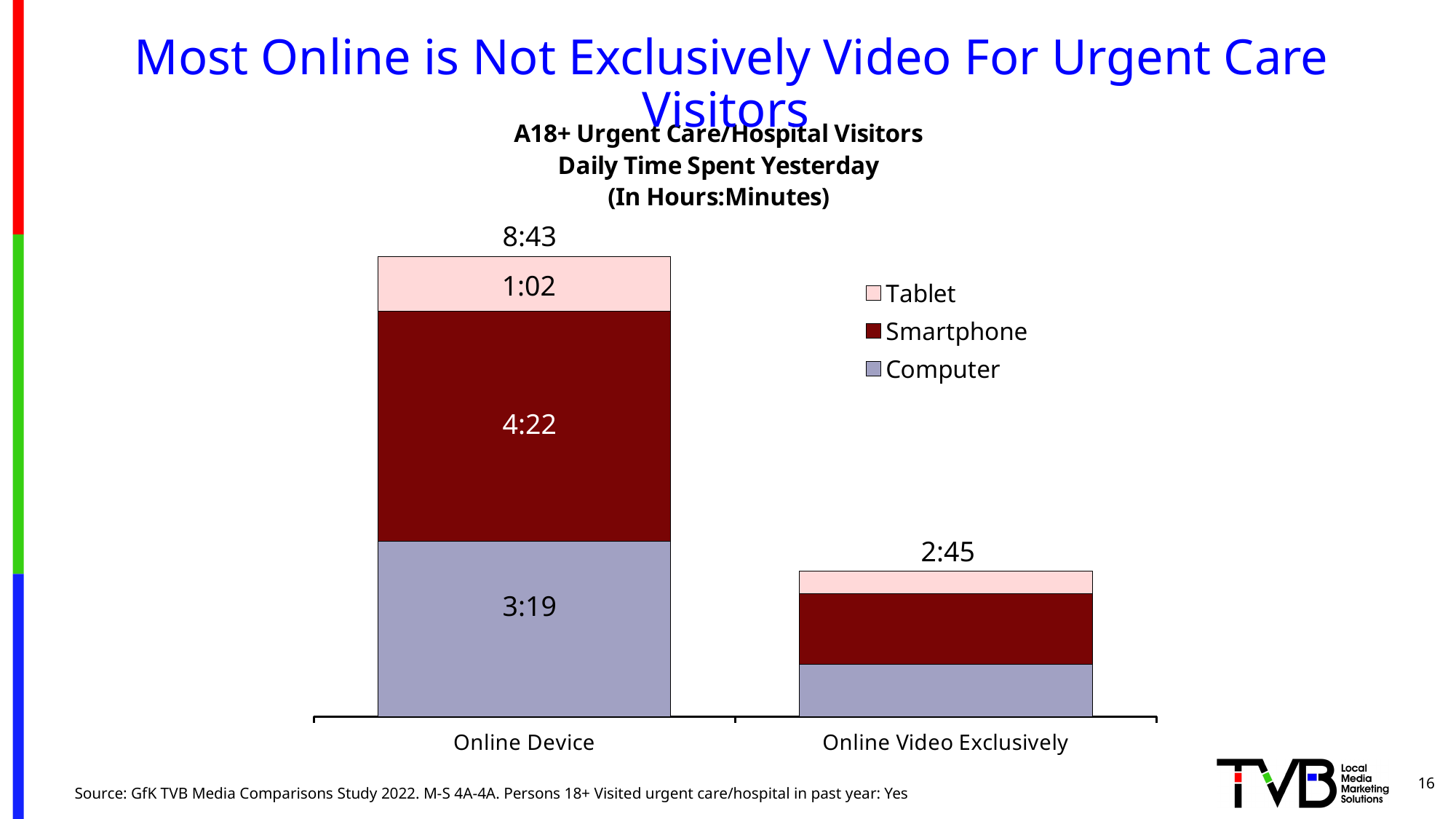
What is the difference between the total for Online Device and the total for Online Video Exclusively? 5:58 How many series does the chart's legend list? 3 Which category has the larger total daily time spent, Online Device or Online Video Exclusively? Online Device What is the total daily time spent for Online Device? 8:43 What is the Smartphone value for Online Device? 4:22 How many categories are shown on the x axis of the chart? 2 What is the Computer value for Online Device? 3:19 Which device accounts for the smallest share of time in the Online Device bar? Tablet Which device accounts for the largest share of time in the Online Device bar? Smartphone What is the Tablet value for Online Device? 1:02 What is the total daily time spent for Online Video Exclusively? 2:45 What kind of chart is shown on the slide? Stacked bar chart